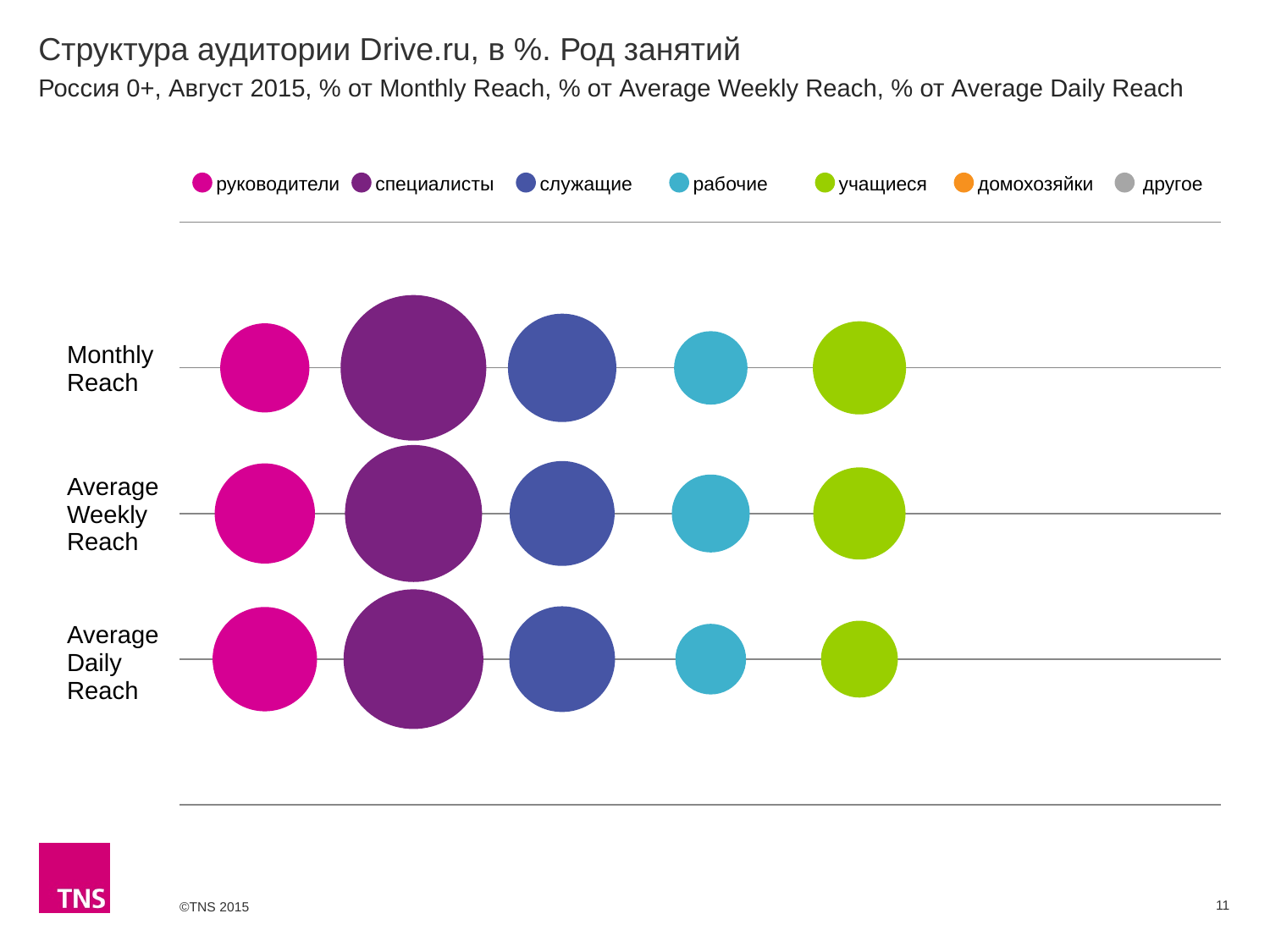
What is the title of the chart on the slide? Структура аудитории Drive.ru, в %. Род занятий In the Average Daily Reach row, which bubble is larger: руководители or рабочие? руководители How many reach categories (rows) are plotted on the chart? 3 In the Average Weekly Reach row, which bubble is larger: специалисты or рабочие? специалисты How many series does the legend list? 7 Which occupation group has the largest bubble in the Average Daily Reach row? специалисты What kind of chart is shown on the slide? bubble chart In the Monthly Reach row, which bubble is larger: служащие or рабочие? служащие Which legend entry is shown in orange? домохозяйки Which occupation group has the largest bubble in the Monthly Reach row? специалисты